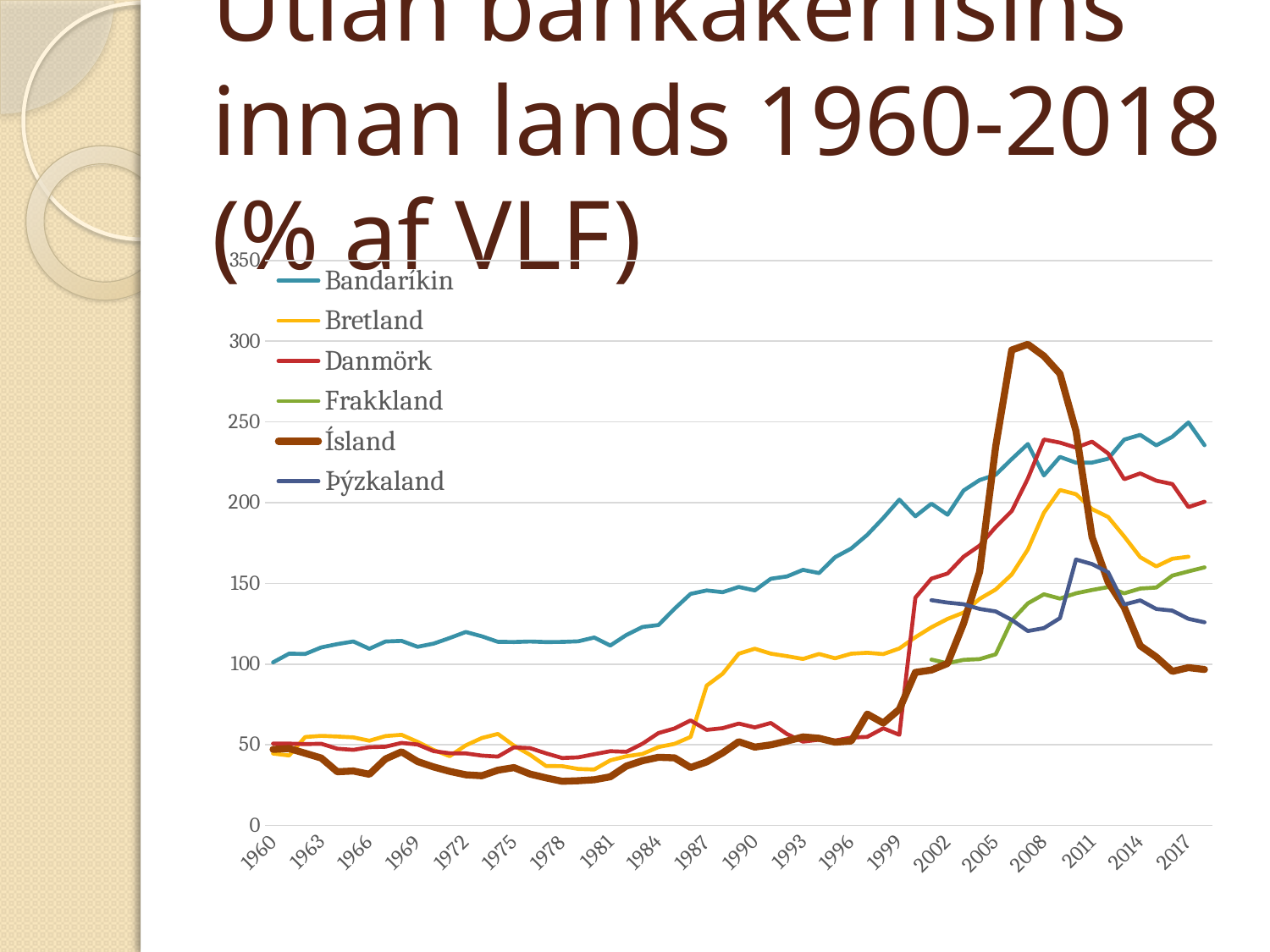
Is the value for Þýzkaland in 2017 greater or less than 150? less Which series reaches the highest value anywhere on the chart? Ísland Which series is drawn with the thickest line? Ísland Which series has the lowest value around 1978? Ísland How many series does the legend list? 6 Is the value for Frakkland in 2018 greater or less than 200? less Is the value for Ísland in 2007 greater or less than 250? greater Which is larger in 2011, the value for Danmörk or the value for Þýzkaland? Danmörk Does the Ísland series rise or fall between 2008 and 2018? fall What kind of chart is shown on the slide? line chart Which is larger in 2018, the value for Bandaríkin or the value for Ísland? Bandaríkin